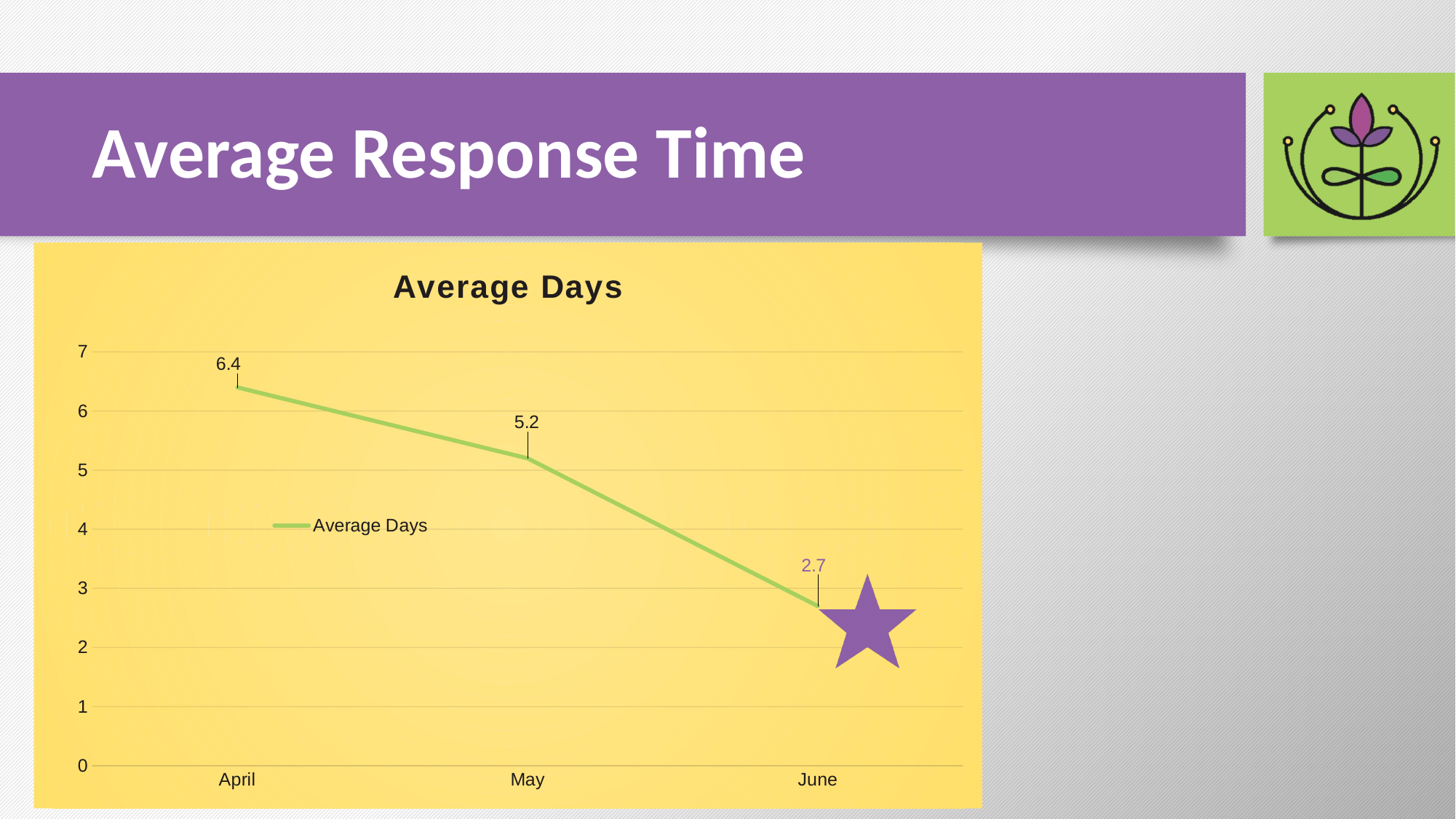
What is the value for April? 6.4 Which month has the highest value? April What is the value for June? 2.7 What kind of chart is shown? line chart What is the difference between the values for April and June? 3.7 Which is larger, the value for April or the value for May? April How many months are plotted on the chart? 3 What is the difference between the values for May and June? 2.5 Which month has the lowest value? June What is the value for May? 5.2 Is the value for June greater or less than 3? less Do the values rise or fall from April to June? fall